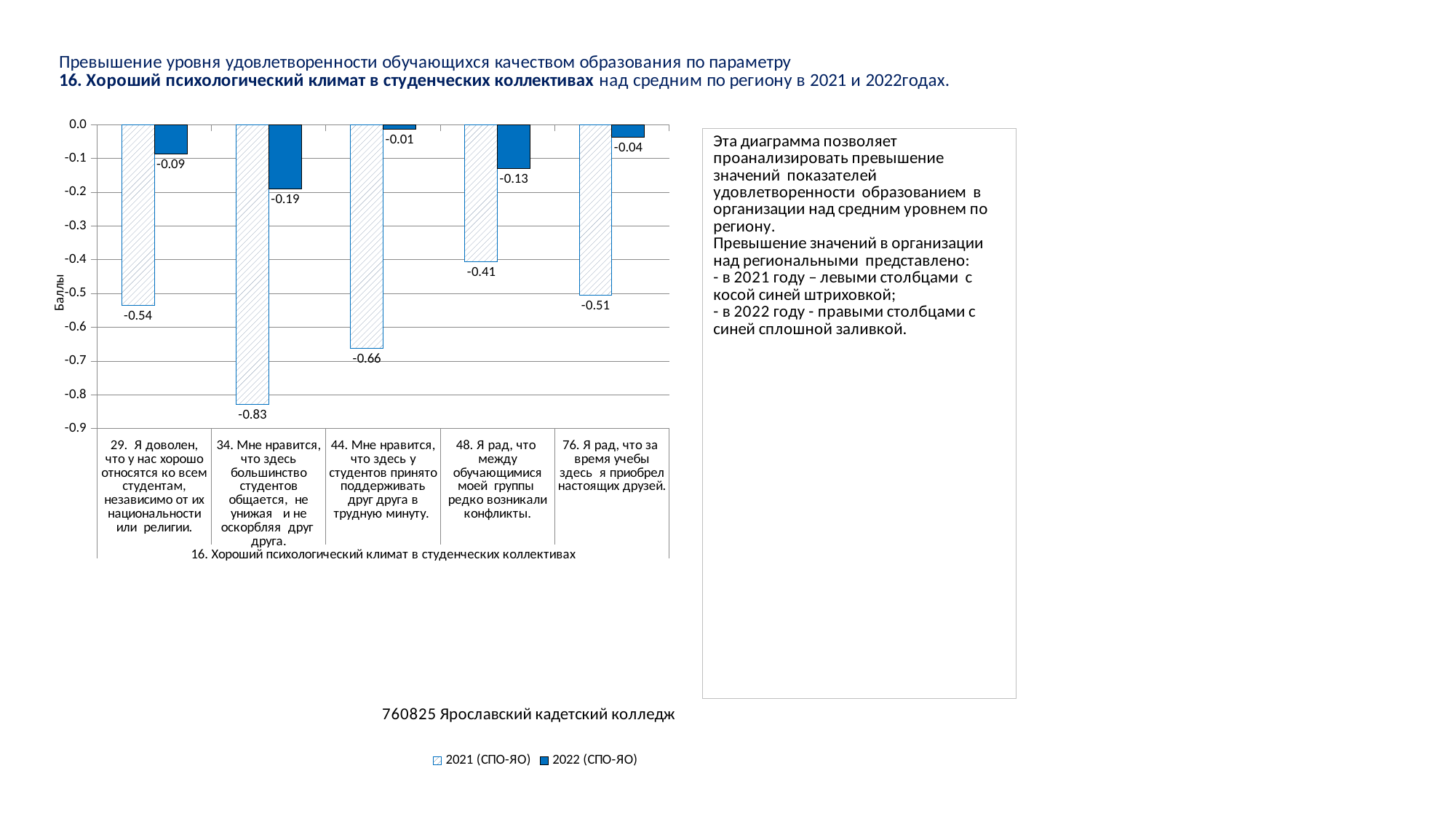
Which item has the highest 2022 (СПО-ЯО) value? 44. Мне нравится, что здесь у студентов принято поддерживать друг друга в трудную минуту. What is the 2022 (СПО-ЯО) value for item 34 ("Мне нравится, что здесь большинство студентов общается, не унижая и не оскорбляя друг друга")? -0.19 Which item has the lowest 2021 (СПО-ЯО) value? 34. Мне нравится, что здесь большинство студентов общается, не унижая и не оскорбляя друг друга. What is the 2022 (СПО-ЯО) value for item 76 ("Я рад, что за время учебы здесь я приобрел настоящих друзей")? -0.04 What is the label of the vertical axis of the chart? Баллы What is the difference between the 2021 and 2022 values for item 48 ("Я рад, что между обучающимися моей группы редко возникали конфликты")? 0.28 How many series does the legend list? 2 How many items (categories) are shown on the x axis of the chart? 5 Which is larger: the 2021 (СПО-ЯО) value for item 29 or for item 76? Item 76 (-0.51) What type of chart is shown on the slide? Bar chart What is the 2021 (СПО-ЯО) value for item 29 ("Я доволен, что у нас хорошо относятся ко всем студентам...")? -0.54 What is the 2021 (СПО-ЯО) value for item 44 ("Мне нравится, что здесь у студентов принято поддерживать друг друга в трудную минуту")? -0.66